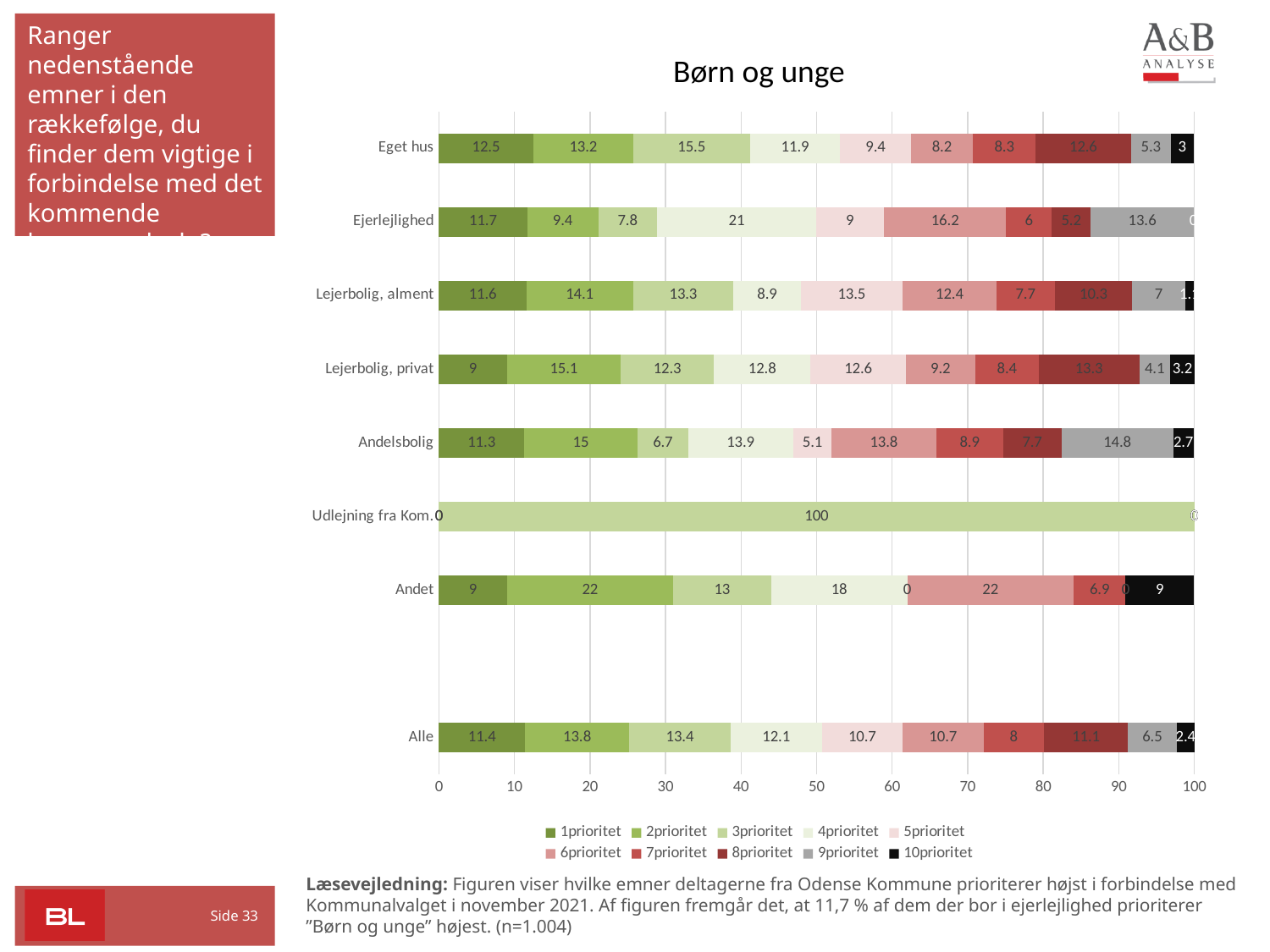
What is the value for 9prioritet for Andelsbolig? 14.8 What kind of chart is shown on the slide? Stacked bar chart What is the value for 3prioritet for Udlejning fra Kom.? 100 What is the title of the chart? Børn og unge What is the difference between the 1prioritet value for Eget hus and the 1prioritet value for Alle? 1.1 What is the value for 10prioritet for Alle? 2.4 What is the value for 1prioritet for Eget hus? 12.5 Which category has the highest value for 1prioritet? Eget hus Which is larger: the 2prioritet value for Andet or the 2prioritet value for Eget hus? Andet How many categories are shown on the y axis of the chart? 8 How many series does the legend list? 10 What is the value for 4prioritet for Ejerlejlighed? 21